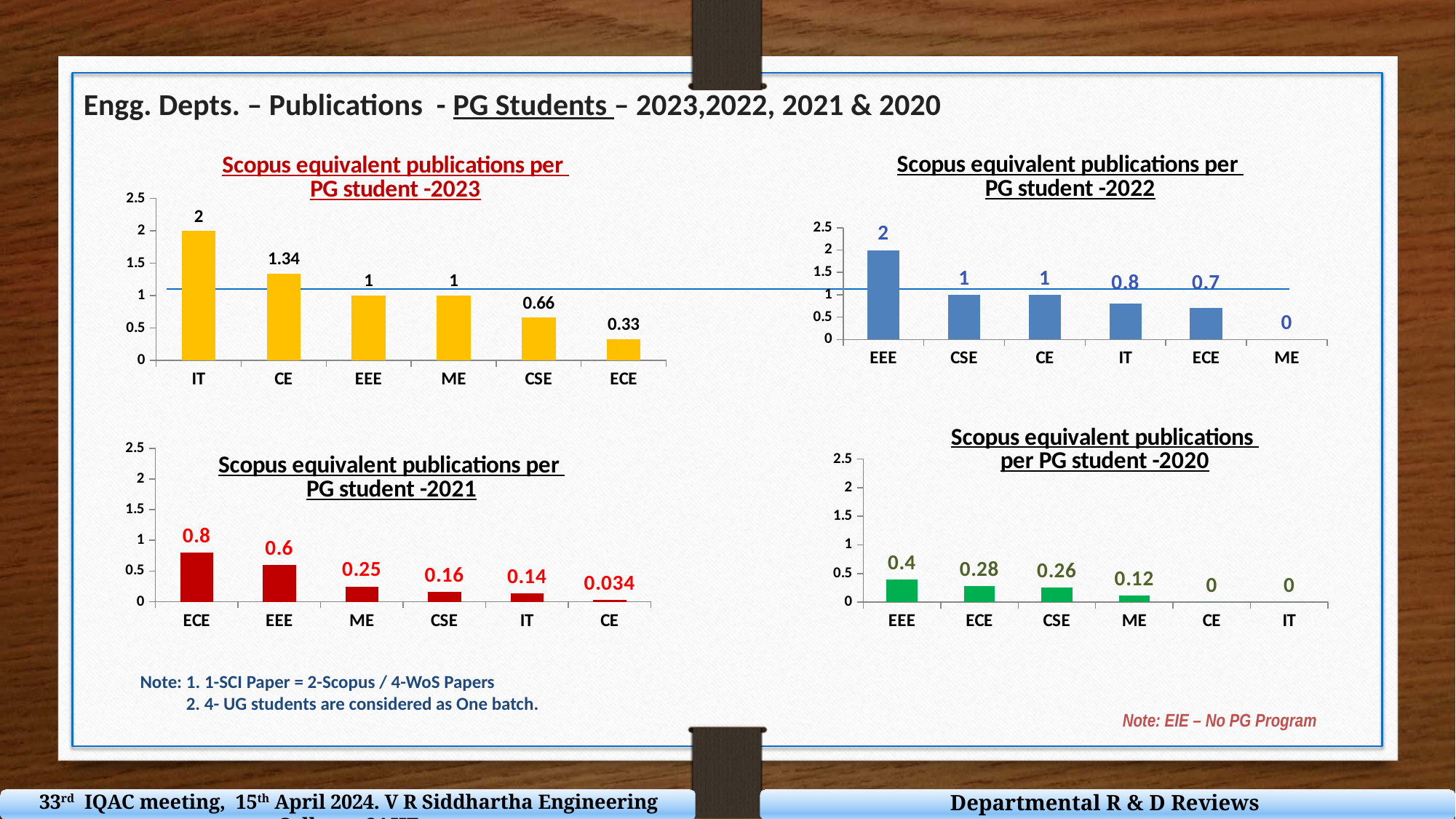
In the 'Scopus equivalent publications per PG student -2022' chart, which department has the lowest value? ME In the 'Scopus equivalent publications per PG student -2020' chart, what is the value for CSE? 0.26 What kind of chart is the 'Scopus equivalent publications per PG student -2020' chart? bar chart In the 'Scopus equivalent publications per PG student -2021' chart, what is the value for CE? 0.034 In the 'Scopus equivalent publications per PG student -2021' chart, do the values rise or fall from left to right along the x axis? fall In the 'Scopus equivalent publications per PG student -2023' chart, what is the difference between the values for IT and ECE? 1.67 In the 'Scopus equivalent publications per PG student -2022' chart, how many departments are shown on the x axis? 6 In the 'Scopus equivalent publications per PG student -2020' chart, what is the difference between the values for EEE and ME? 0.28 In the 'Scopus equivalent publications per PG student -2023' chart, what is the value for CE? 1.34 In the 'Scopus equivalent publications per PG student -2023' chart, which department has the highest value? IT In the 'Scopus equivalent publications per PG student -2022' chart, what is the value for ECE? 0.7 In the 'Scopus equivalent publications per PG student -2021' chart, which is larger, the value for ECE or the value for EEE? ECE